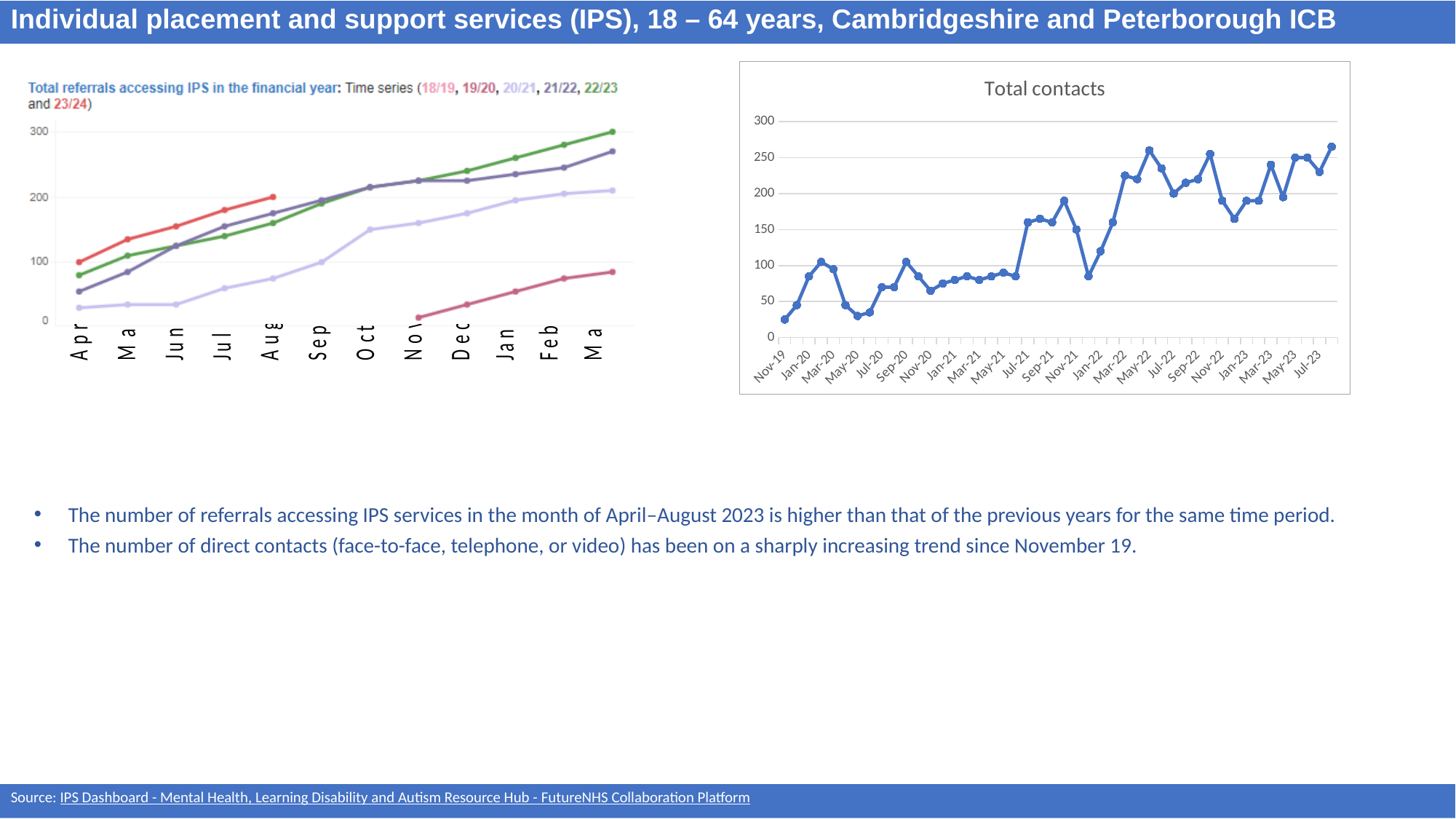
In the 'Total contacts' chart, do the values generally rise or fall from Nov-19 to Jul-23? rise In the 'Total referrals accessing IPS in the financial year' chart, is the 23/24 value for Aug greater or less than 150? greater In the 'Total referrals accessing IPS in the financial year' chart, which financial-year series has the highest value in Mar? 22/23 In the 'Total referrals accessing IPS in the financial year' chart, is the 22/23 value for Mar greater or less than 250? greater In the 'Total contacts' chart, is the value for Jul-23 greater or less than 200? greater How many financial-year series does the 'Total referrals accessing IPS in the financial year' chart show? 6 What kind of chart is the 'Total contacts' chart on the right of the slide? line chart How many months are shown on the x axis of the 'Total referrals accessing IPS in the financial year' chart? 12 In the 'Total referrals accessing IPS in the financial year' chart, which financial-year series has the lowest value in Apr? 20/21 What kind of chart is the 'Total referrals accessing IPS in the financial year' chart on the left of the slide? line chart